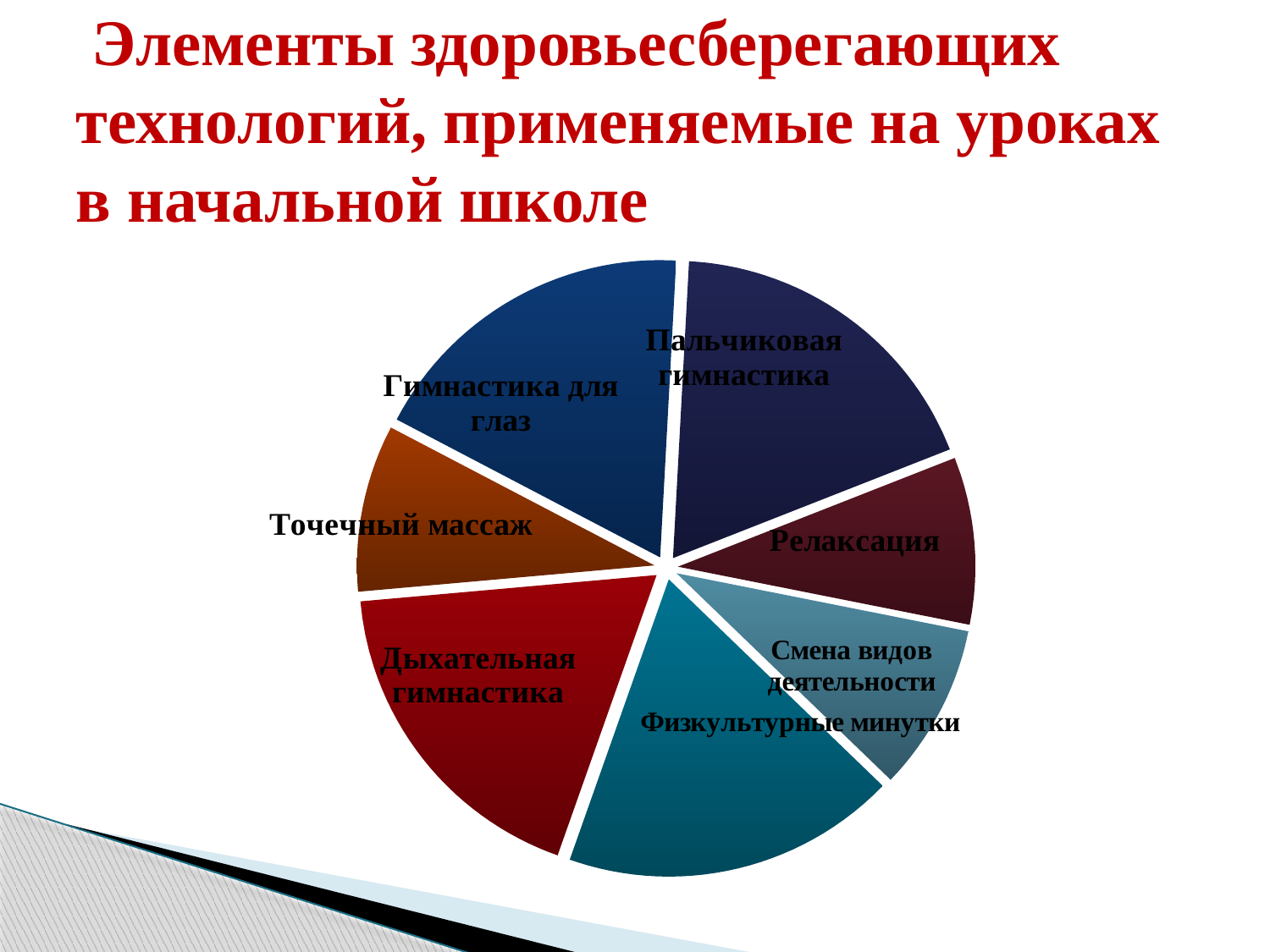
How many slices does the pie chart have? 7 Which slice is larger, Пальчиковая гимнастика or Релаксация? Пальчиковая гимнастика What colour is the Дыхательная гимнастика slice? red Which slice is larger, Релаксация or Физкультурные минутки? Физкультурные минутки Which slice is larger, Гимнастика для глаз or Смена видов деятельности? Гимнастика для глаз What kind of chart is shown on the slide? pie chart What is the title of the slide containing the pie chart? Элементы здоровьесберегающих технологий, применяемые на уроках в начальной школе